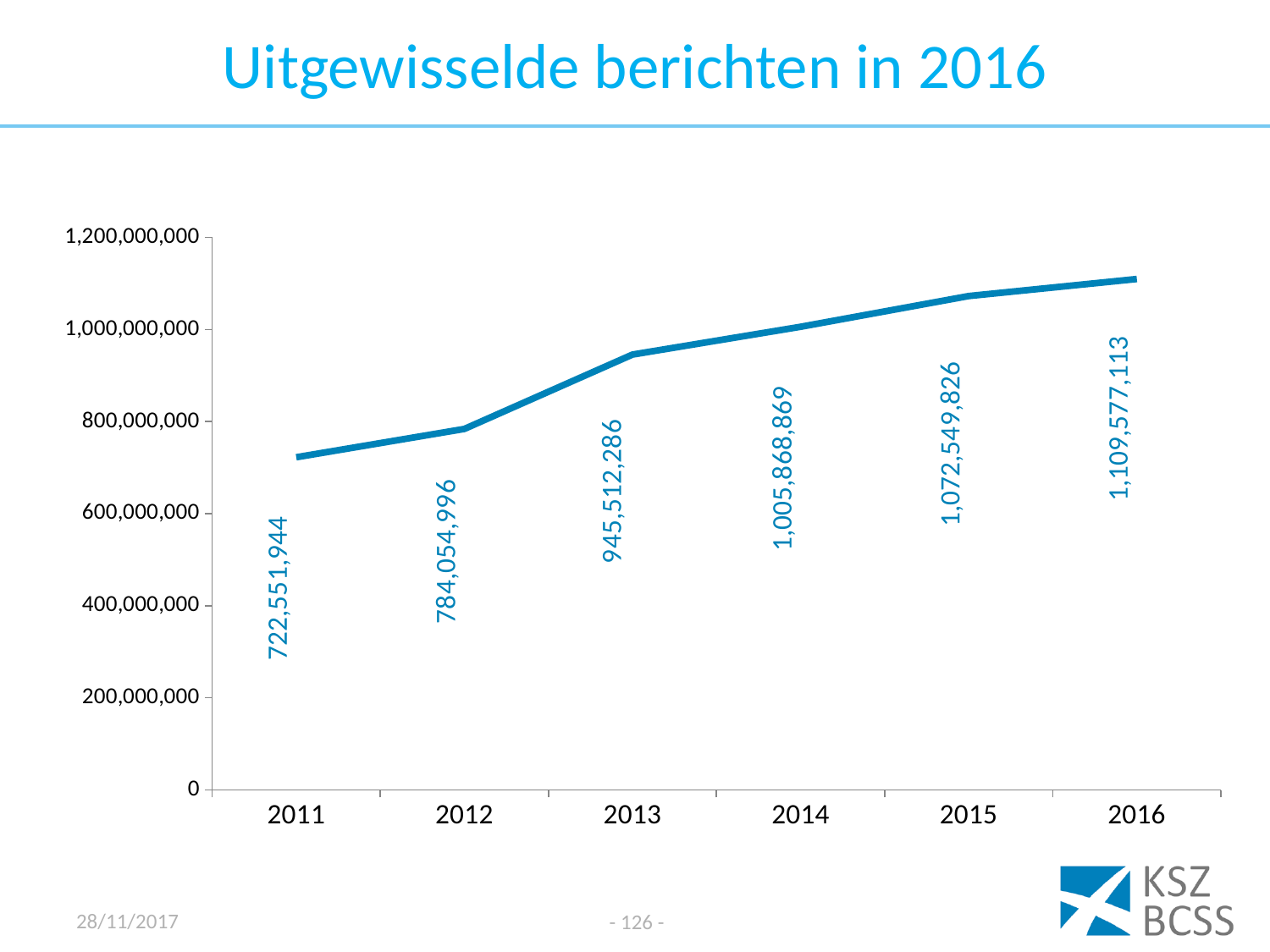
What is the value for 2013? 945,512,286 What is the difference between the values for 2013 and 2012? 161,457,290 What is the value for 2014? 1,005,868,869 Which year has the highest value? 2016 What kind of chart is shown on the slide? Line chart Which year has the lowest value? 2011 What is the value for 2016? 1,109,577,113 How many years are plotted on the chart? 6 Do the values rise or fall from 2011 to 2016? Rise What is the value for 2011? 722,551,944 Which is larger, the value for 2012 or the value for 2015? 2015 What is the difference between the values for 2016 and 2011? 387,025,169